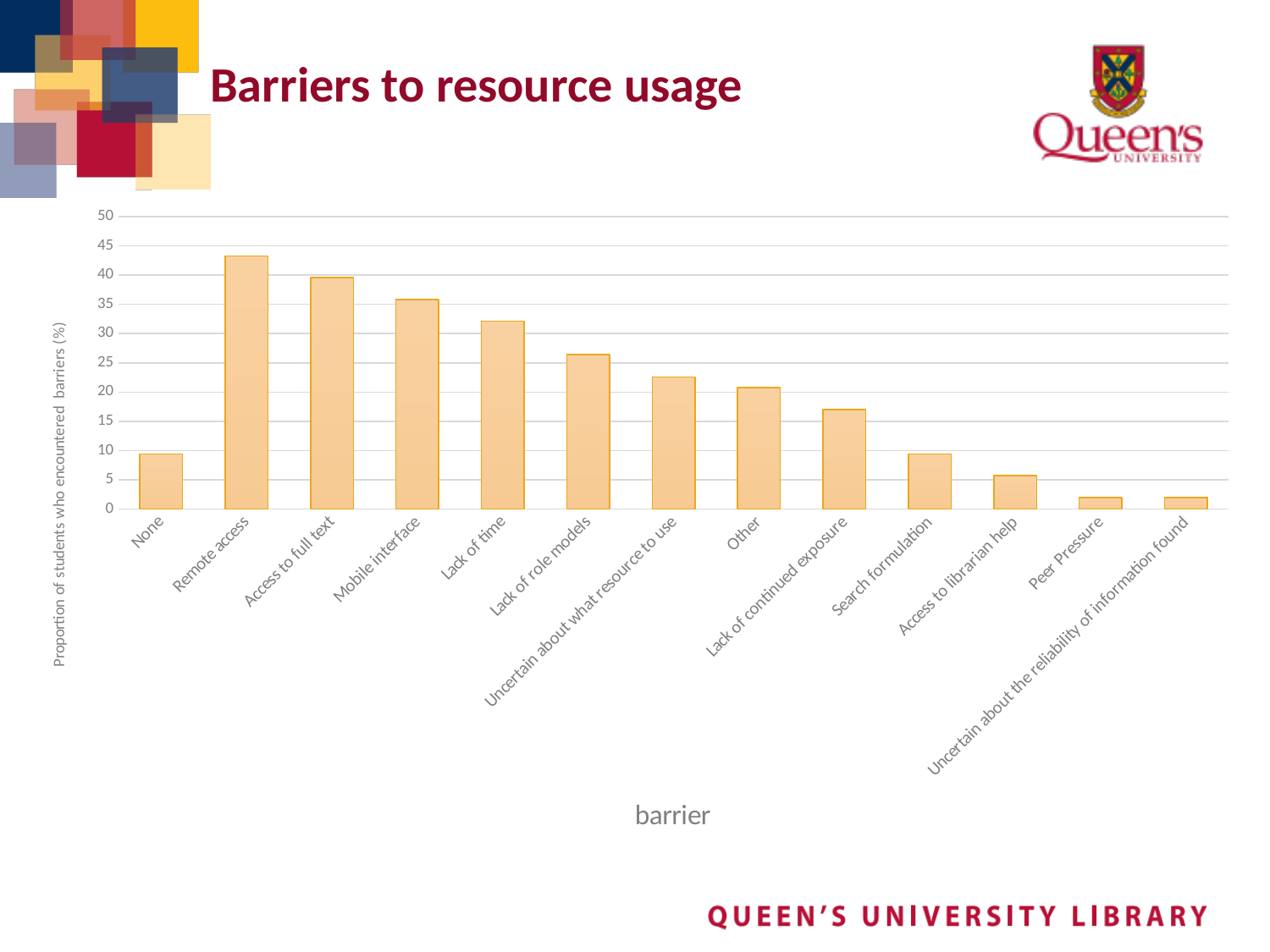
Is the value for Remote access greater or less than 40? greater What is the label on the y axis of the chart? Proportion of students who encountered barriers (%) What is the title of the slide's chart? Barriers to resource usage Which barrier has the highest proportion of students? Remote access What kind of chart is shown on the slide? bar chart Is the value for Access to librarian help greater or less than 10? less How many barrier categories are plotted on the x axis? 13 Is the value for Lack of time greater or less than 30? greater Which is larger, the value for Lack of time or the value for Other? Lack of time